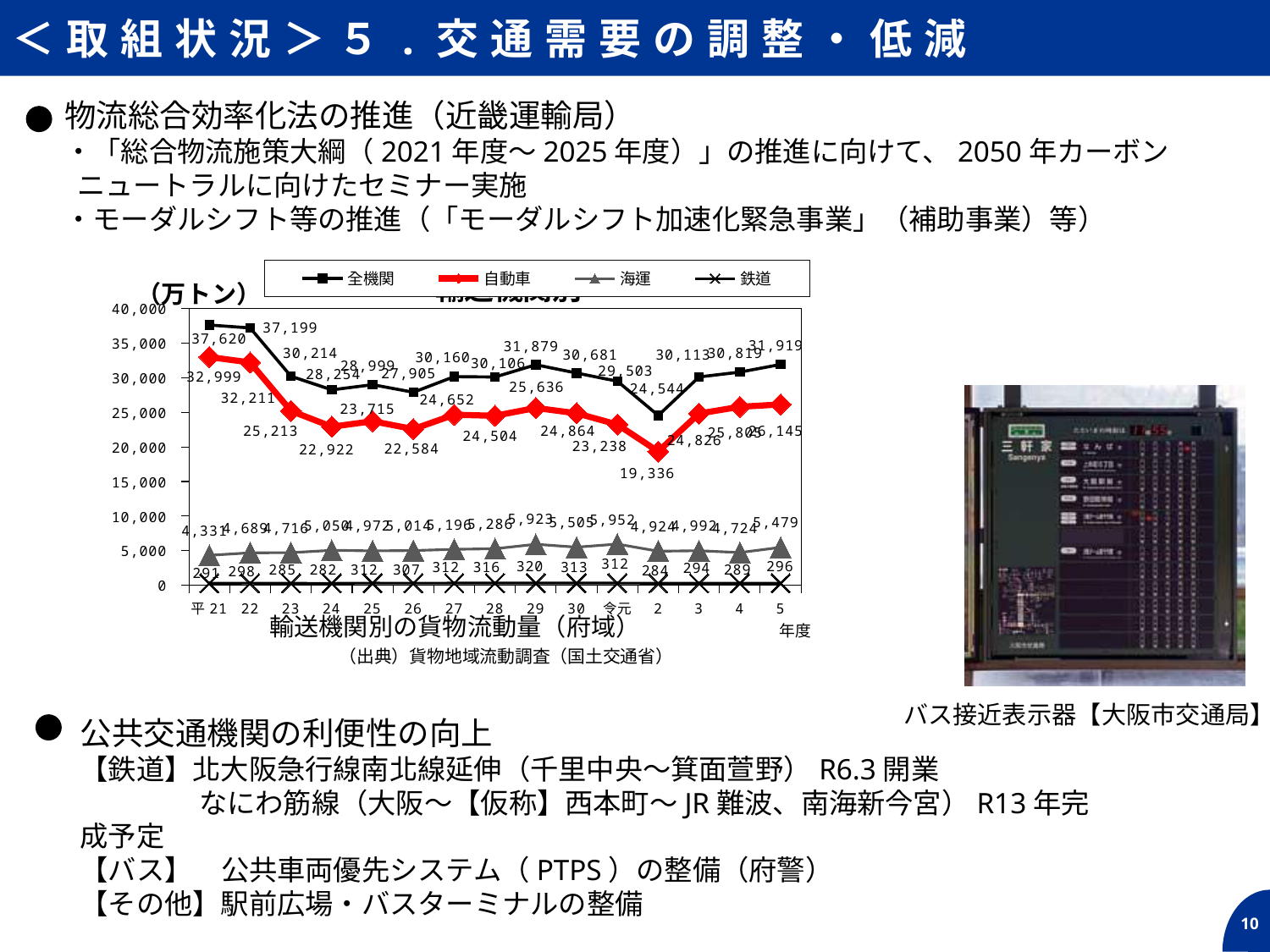
What is the difference between the 全機関 values for 平21 and 平22? 421 What is the value for 全機関 in 平21? 37,620 How many series does the legend of the chart list? 4 What is the value for 自動車 in 令和2? 19,336 In which year is the 鉄道 series at its highest? 平成29 Which is larger for 海運: the value in 平29 or the value in 令元? 令元 What kind of chart is shown on the slide? line chart What unit is shown on the y axis of the chart? 万トン In which year is the 自動車 series at its lowest? 令和2 What is the value for 鉄道 in 令和5? 296 Is the value for 全機関 in 令和2 greater or less than 25,000? less How many years (points) are plotted along the x axis of the chart? 15